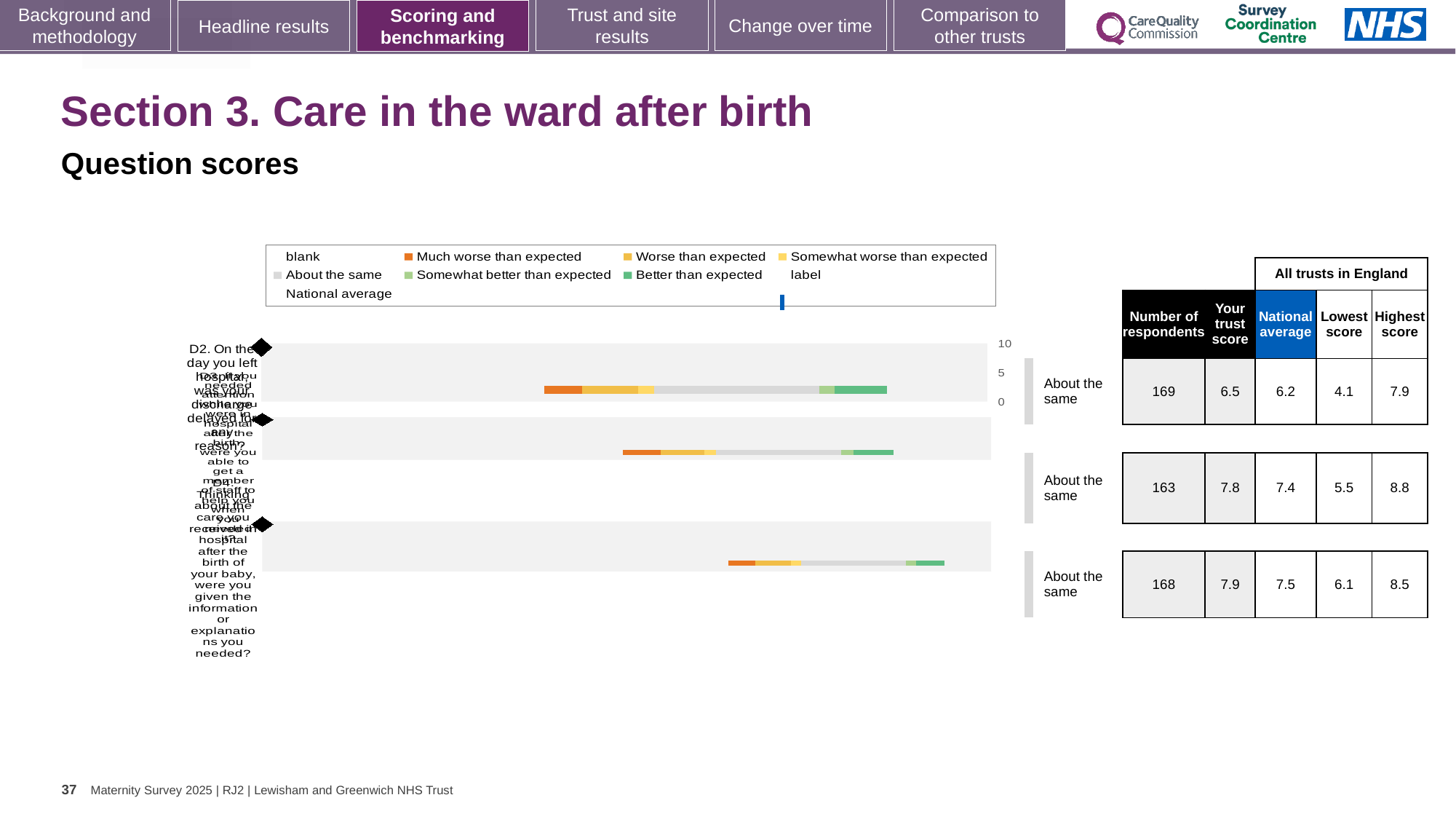
For the first (top) question, what is the difference between the highest score and the lowest score across all trusts in England? 3.8 What comparison label is shown next to each of the three question bars? About the same In the table beside the chart, what is the 'Your trust score' for the second (middle) question? 7.8 How many question bars are plotted in the chart? 3 In the table beside the chart, what is the national average for the third (bottom) question? 7.5 Which question row has the lowest number of respondents in the table beside the chart? the second (middle) row, 163 For the first (top) question, which is larger: the trust score or the national average? the trust score (6.5) Which question row has the highest 'Your trust score' in the table beside the chart? the third (bottom) row, 7.9 What kind of chart is shown on the slide? bar chart How many entries does the chart legend list? 9 In the table beside the chart, what is the number of respondents for the first (top) question? 169 What is the highest tick value shown on the chart's score axis? 10